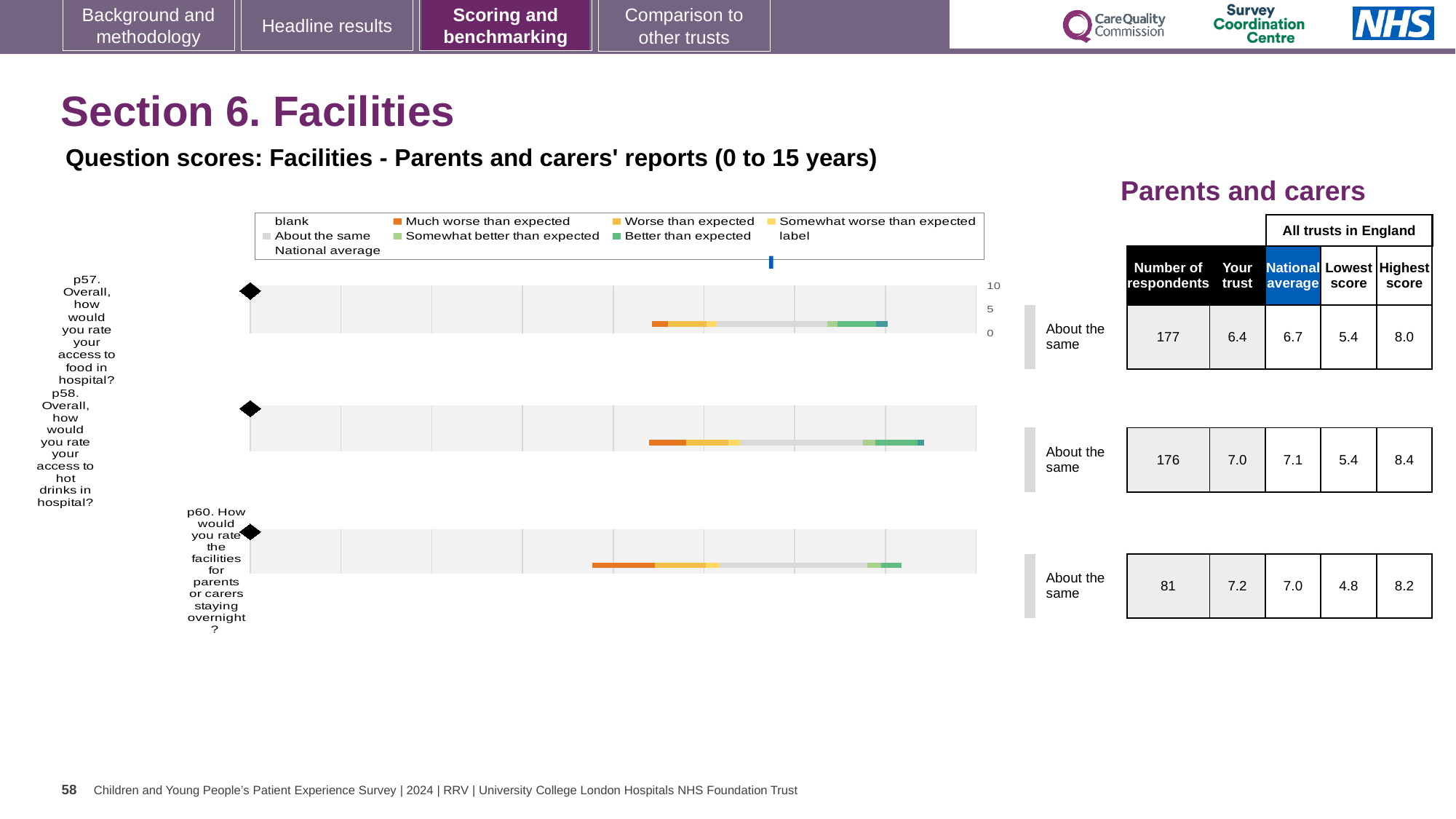
Which question has the fewest respondents? p60 For p60, which is larger: the 'Your trust' score or the national average? Your trust What is the highest score across all trusts in England for p58? 8.4 Which legend entry is shown in dark orange in the chart legend? Much worse than expected How many respondents answered p60 (facilities for parents or carers staying overnight)? 81 What is the national average score for p58 (access to hot drinks in hospital)? 7.1 What is the maximum value shown on the score axis of the chart? 10 How many survey questions are plotted in the Facilities chart on this slide? 3 Which question has the highest 'Your trust' score: p57, p58 or p60? p60 What is the difference between the highest score and the lowest score for p57? 2.6 What is the 'Your trust' score for p57 (access to food in hospital)? 6.4 What kind of chart is used to show the question scores on this slide? bar chart